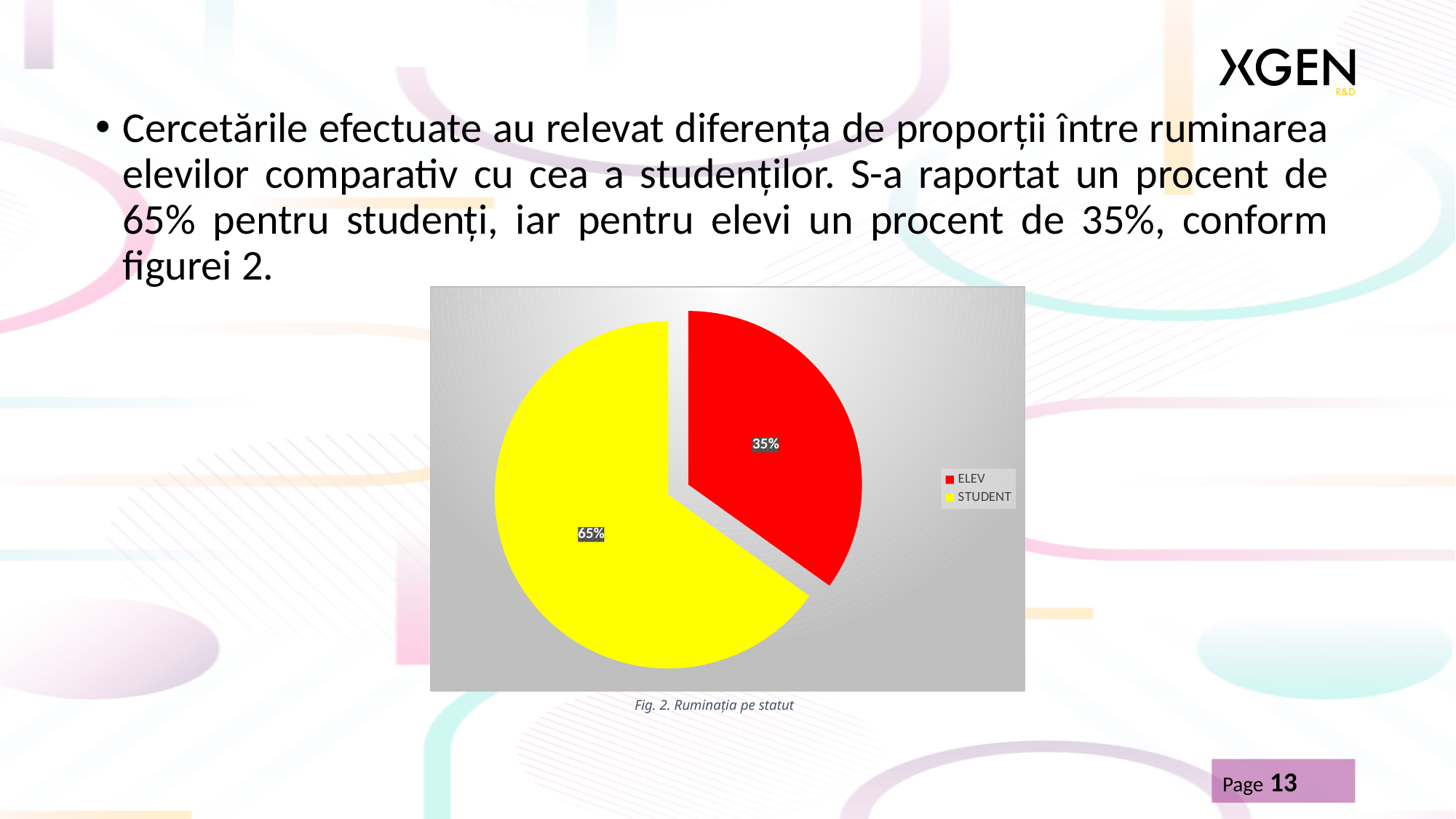
Which is larger, the ELEV slice or the STUDENT slice? STUDENT How many categories does the pie chart show? 2 What kind of chart is shown on the slide? pie chart What share of the pie does STUDENT have? 65% Which category has the largest slice of the pie? STUDENT What colour is the ELEV slice? red Which category has the smallest slice of the pie? ELEV What share of the pie does ELEV have? 35% What is the difference in percentage points between the STUDENT and ELEV slices? 30 What is the caption of the figure below the chart? Fig. 2. Ruminația pe statut How many entries does the legend list? 2